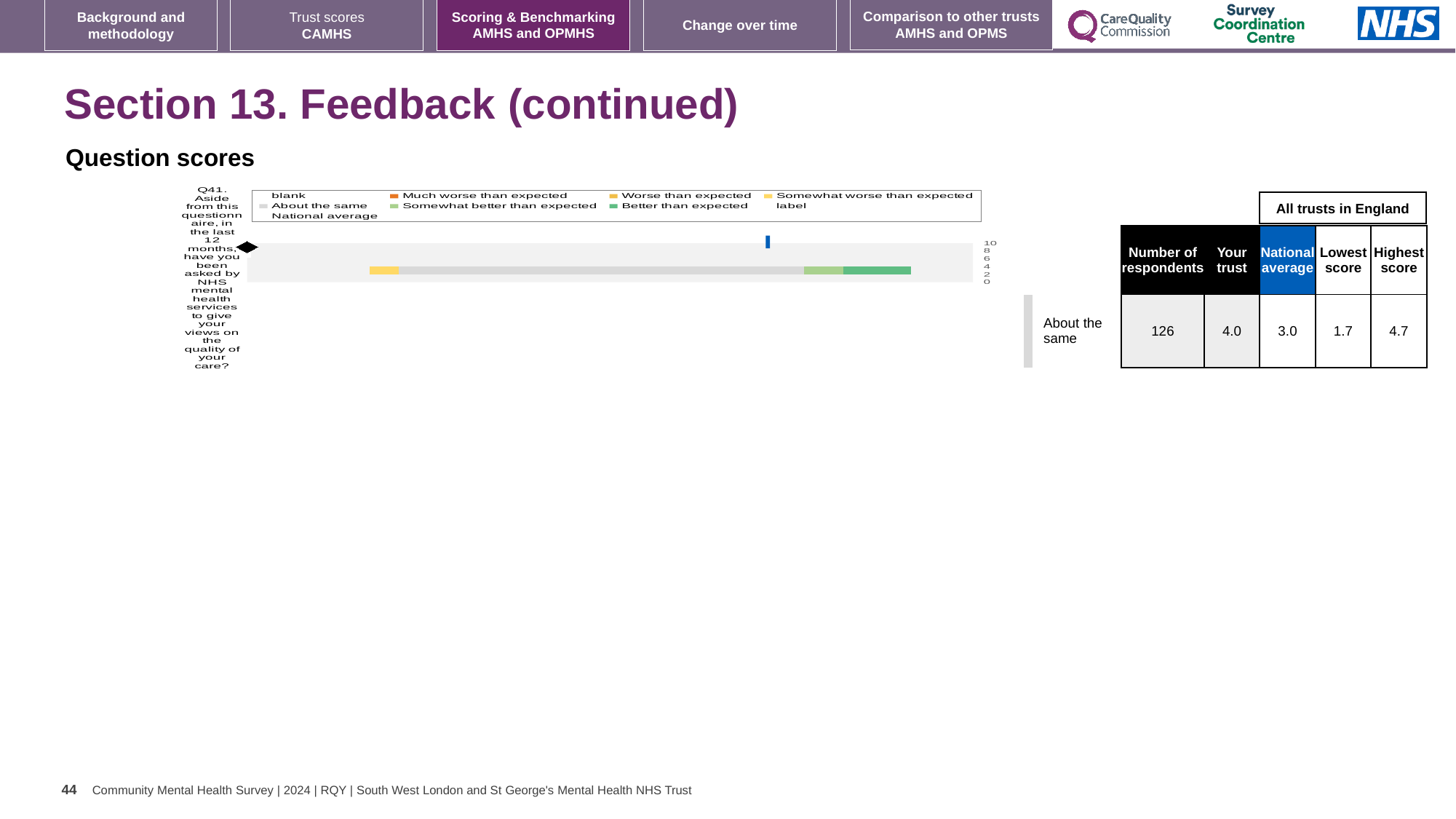
What benchmark category is the trust's Q41 score placed in? About the same Which question is shown on the chart? Q41 What is the number of respondents for Q41? 126 What is the national average score for Q41? 3.0 What kind of chart is used to show the Q41 question score? bar chart What is the difference between the 'Your trust' score and the national average for Q41? 1.0 Which is larger for Q41, the 'Your trust' score or the national average? Your trust How many survey questions are plotted on the chart? 1 What is the lowest score among all trusts in England for Q41? 1.7 What is the highest score among all trusts in England for Q41? 4.7 What is the 'Your trust' score for Q41? 4.0 What is the difference between the highest and lowest scores for Q41? 3.0